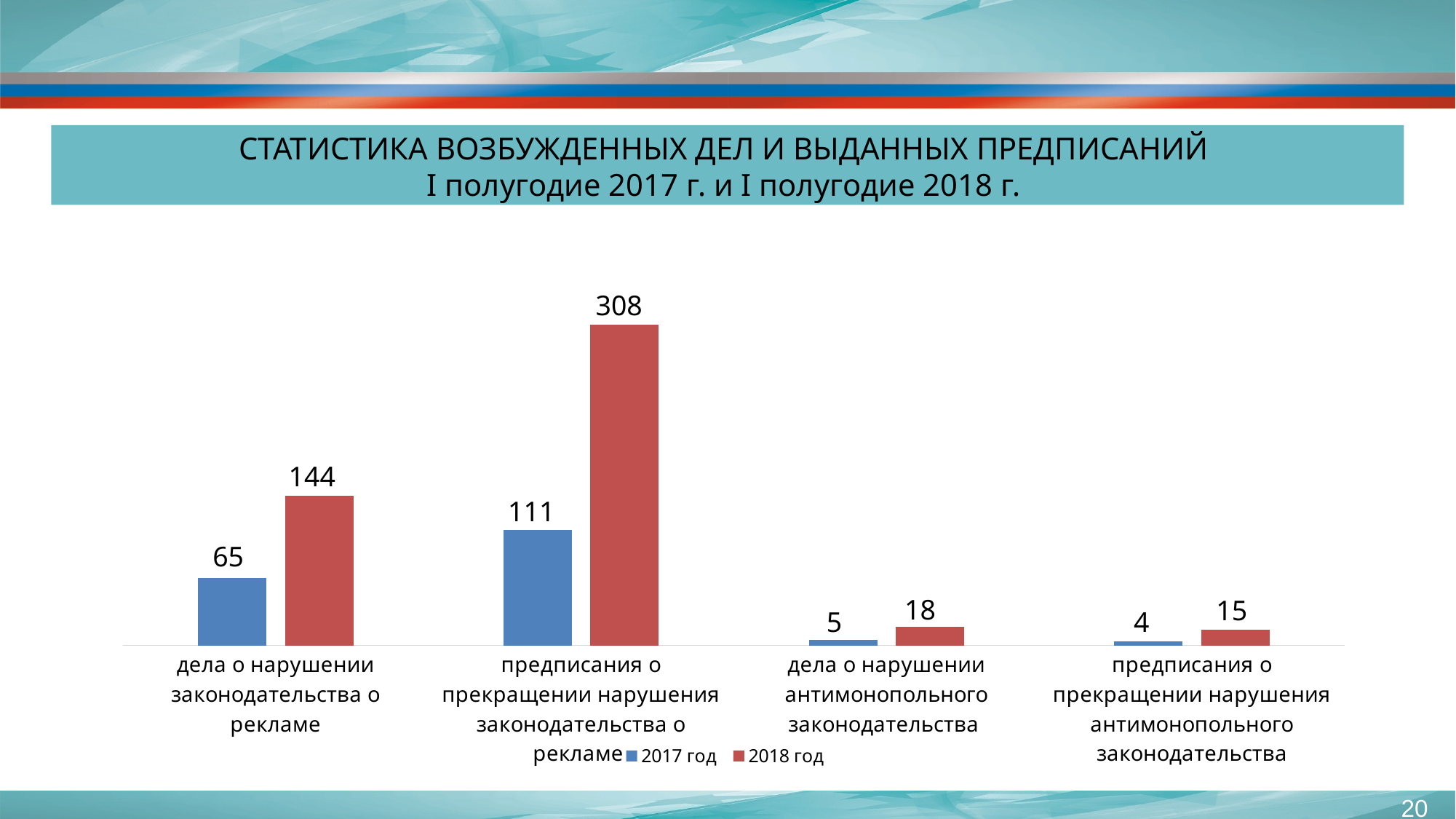
What is the value for 2017 год for 'дела о нарушении антимонопольного законодательства'? 5 What is the difference between the 2018 год and 2017 год values for 'предписания о прекращении нарушения законодательства о рекламе'? 197 What is the value for 2018 год for 'предписания о прекращении нарушения законодательства о рекламе'? 308 How many categories are shown on the x axis? 4 What is the difference between the 2018 год and 2017 год values for 'дела о нарушении законодательства о рекламе'? 79 Which category has the highest value for 2018 год? предписания о прекращении нарушения законодательства о рекламе What is the value for 2018 год for 'предписания о прекращении нарушения антимонопольного законодательства'? 15 Which is larger: the 2018 год value for 'дела о нарушении антимонопольного законодательства' or the 2018 год value for 'предписания о прекращении нарушения антимонопольного законодательства'? дела о нарушении антимонопольного законодательства How many series does the legend list? 2 What kind of chart is shown on the slide? bar chart Which category has the lowest value for 2017 год? предписания о прекращении нарушения антимонопольного законодательства What is the value for 2017 год for 'дела о нарушении законодательства о рекламе'? 65